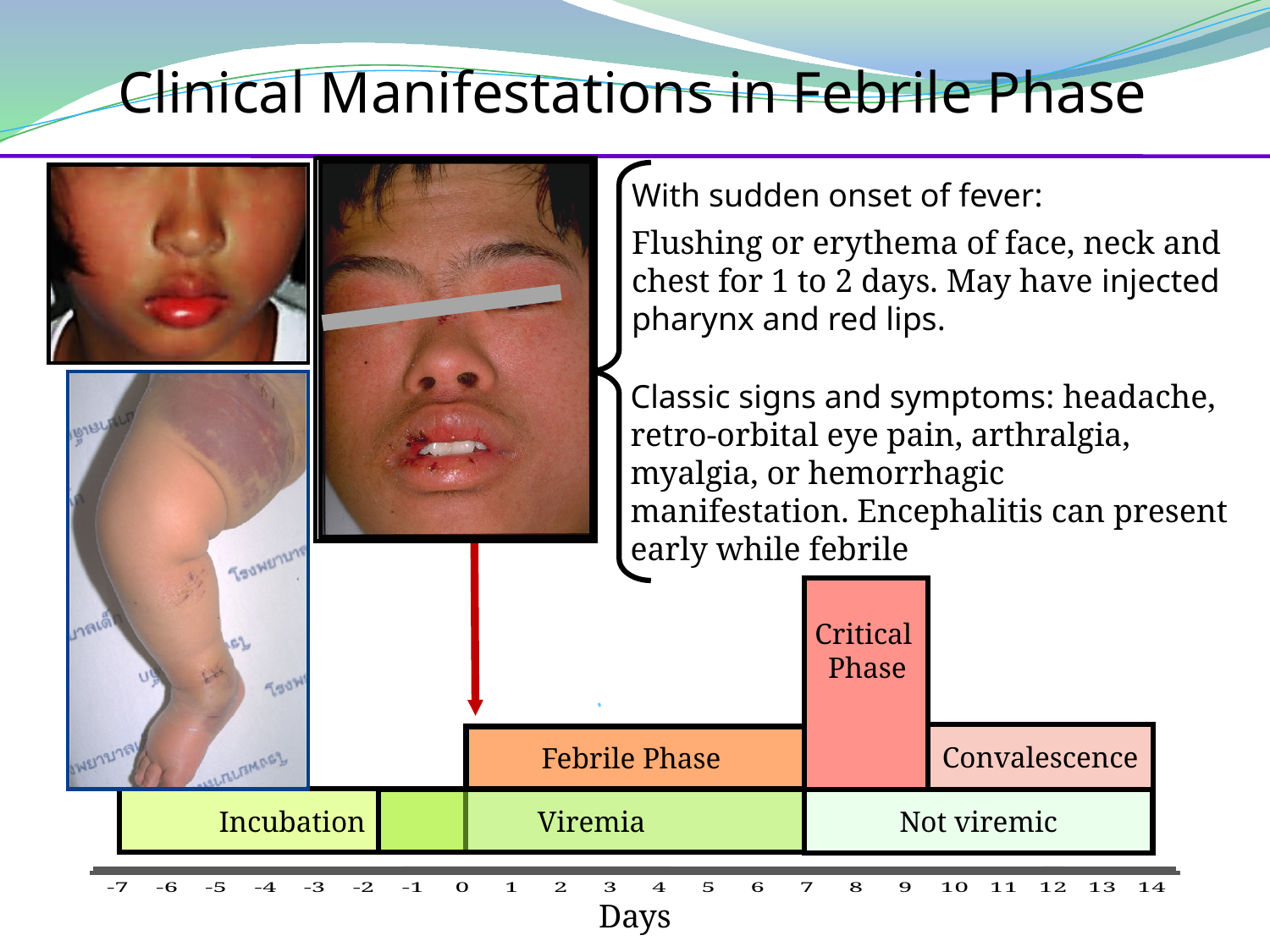
On the timeline chart, what is the label of the horizontal axis? Days On the timeline chart, what is the lowest day value shown on the axis? -7 On the timeline chart, which period is labelled in the bottom row for days 7 to 14? Not viremic On the timeline chart, on which day does the Febrile Phase end and the Critical Phase begin? 7 On the timeline chart, which phase follows the Critical Phase? Convalescence On the timeline chart, on which day does the Febrile Phase begin? 0 On the timeline chart, how many days does the Febrile Phase last? 7 On the timeline chart, on which day does the Viremia period end? 7 On the timeline chart, which lasts longer, the Febrile Phase or the Critical Phase? Febrile Phase On the timeline chart, what is the highest day value shown on the axis? 14